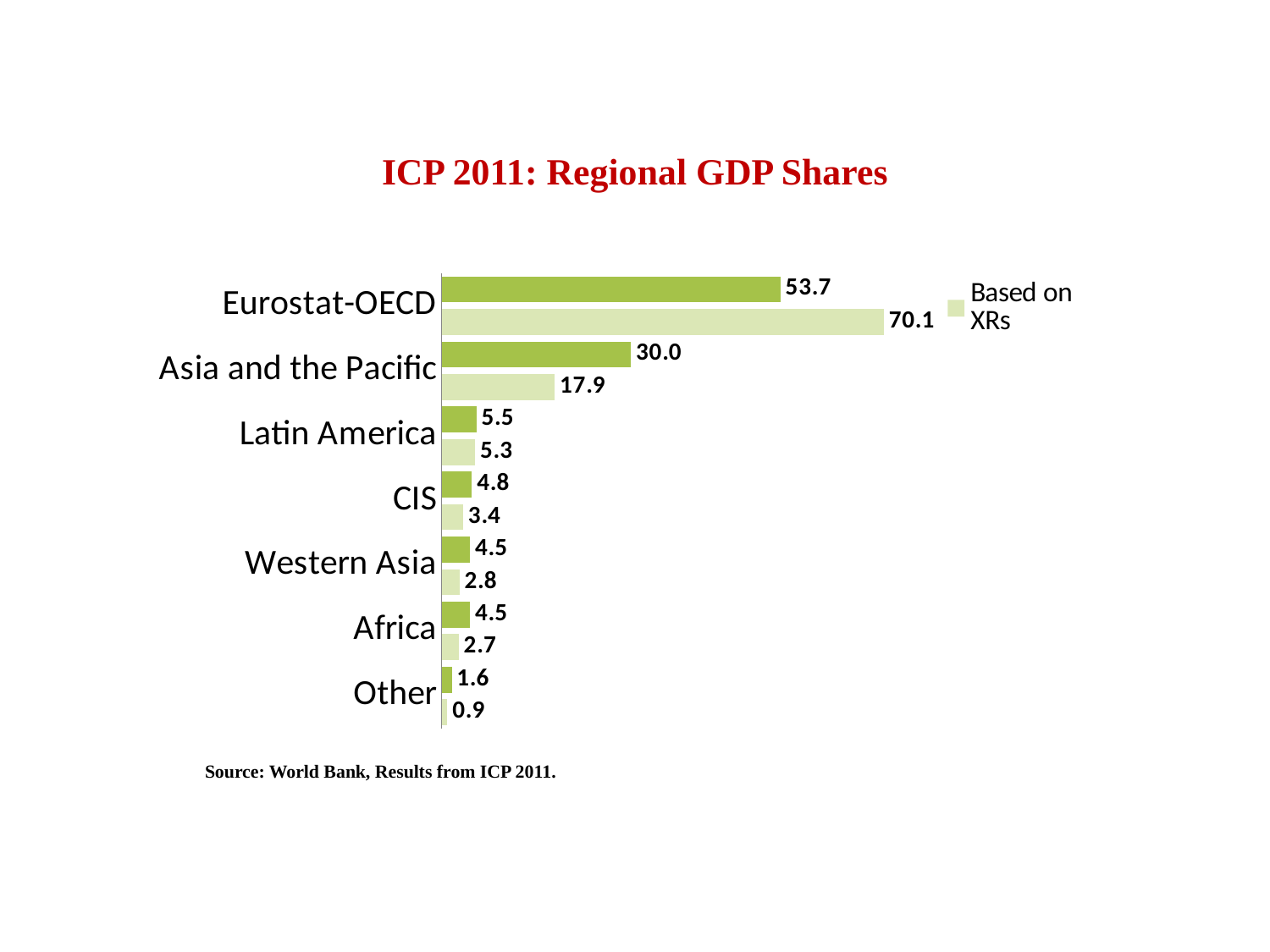
What is the 'Based on XRs' value for Africa? 2.7 For Asia and the Pacific, which bar is larger: the darker green bar or the 'Based on XRs' bar? The darker green bar Which region has the highest 'Based on XRs' value? Eurostat-OECD What is the 'Based on XRs' value for Asia and the Pacific? 17.9 What is the title of the chart? ICP 2011: Regional GDP Shares What is the difference between the 'Based on XRs' values for Eurostat-OECD and Asia and the Pacific? 52.2 What is the 'Based on XRs' value for Eurostat-OECD? 70.1 For Eurostat-OECD, how much larger is the 'Based on XRs' value than the darker green bar's value? 16.4 What kind of chart is shown on the slide? Bar chart What value is shown on the darker green bar for CIS? 4.8 Which region has the lowest 'Based on XRs' value? Other How many regions are shown on the chart? 7